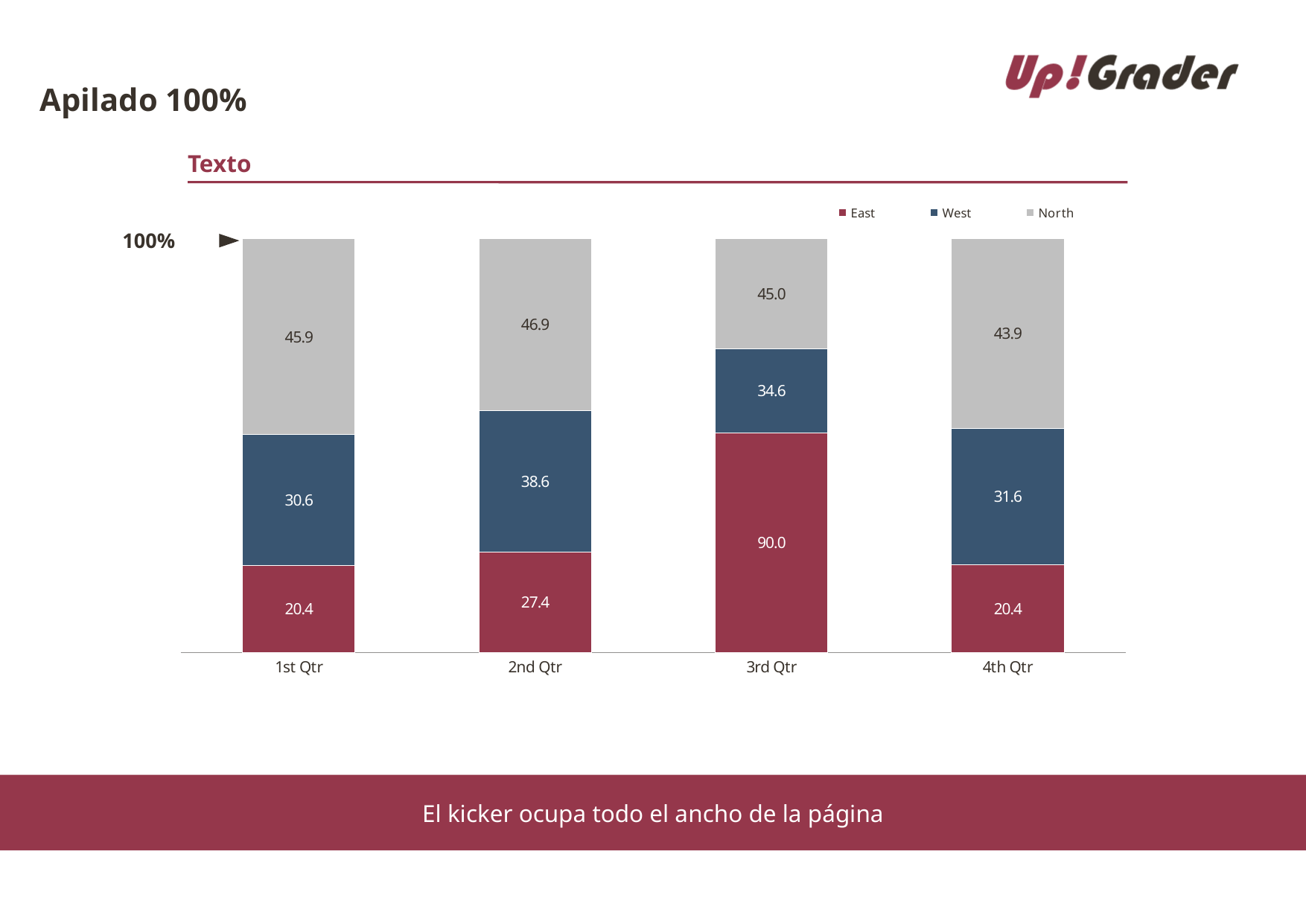
What is the value of the West series for 4th Qtr? 31.6 What is the sum of the three data labels for 1st Qtr? 96.9 What is the value of the North series for 2nd Qtr? 46.9 How many series does the legend list? 3 What kind of chart is shown on the slide? Stacked bar chart How many quarters are shown on the x axis? 4 What is the difference between the West value for 2nd Qtr and the West value for 1st Qtr? 8.0 Which quarter has the lowest North value? 4th Qtr What is the difference between the East value for 3rd Qtr and the East value for 2nd Qtr? 62.6 Which quarter has the highest East value? 3rd Qtr What is the value of the East series for 3rd Qtr? 90.0 Which is larger, the North value for 1st Qtr or the North value for 4th Qtr? 1st Qtr